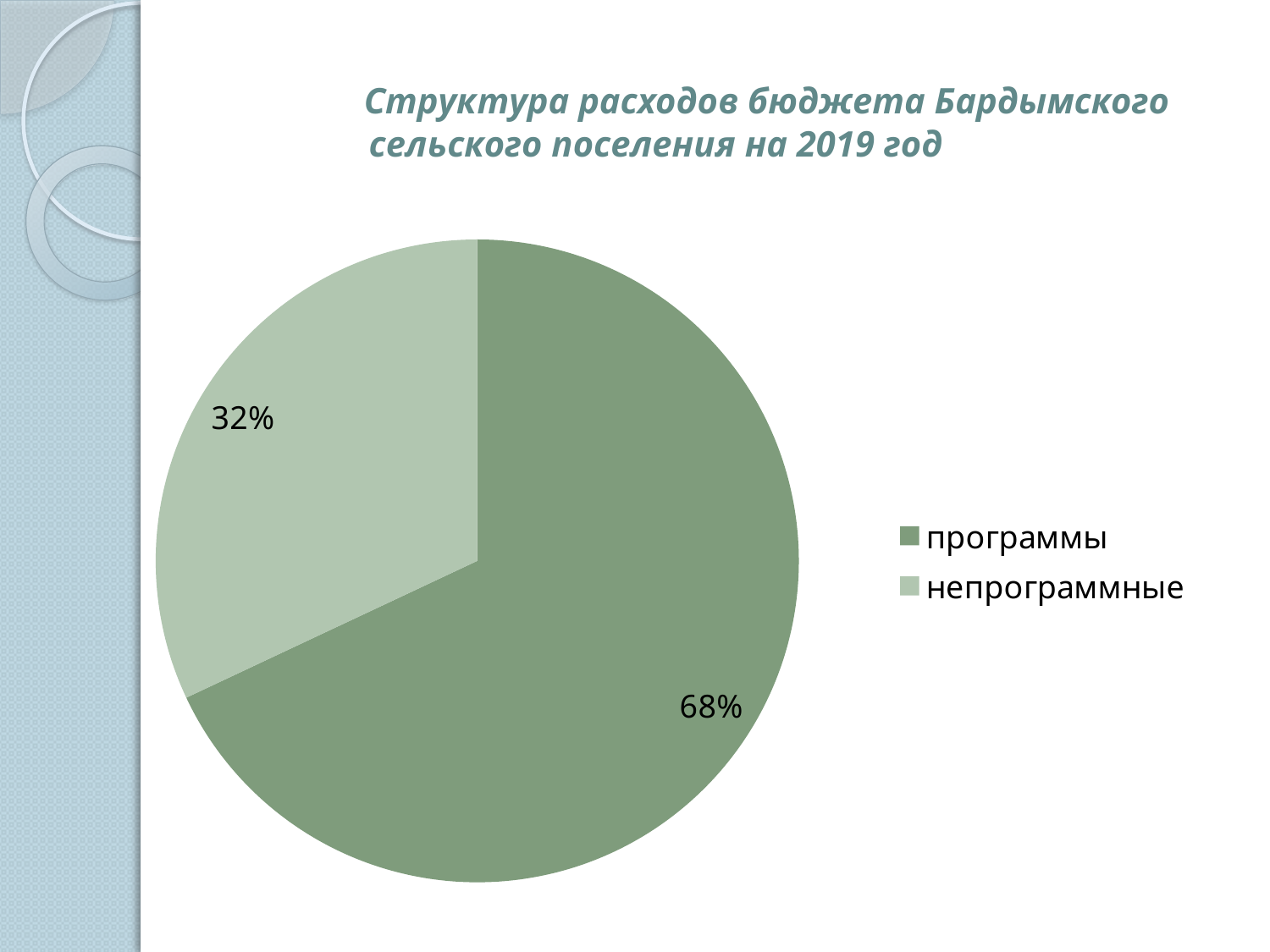
Which legend entry is shown in the lighter green colour? непрограммные What share of the pie does the "непрограммные" slice represent? 32% What share of the pie does the "программы" slice represent? 68% How many entries does the legend list? 2 What kind of chart is shown on the slide? pie chart Which category has the smallest slice of the pie? непрограммные Which category has the largest slice of the pie? программы Which is larger, the "программы" slice or the "непрограммные" slice? программы What is the difference in percentage points between the "программы" and "непрограммные" slices? 36% How many categories are shown in the pie chart? 2 What is the title of the chart on the slide? Структура расходов бюджета Бардымского сельского поселения на 2019 год